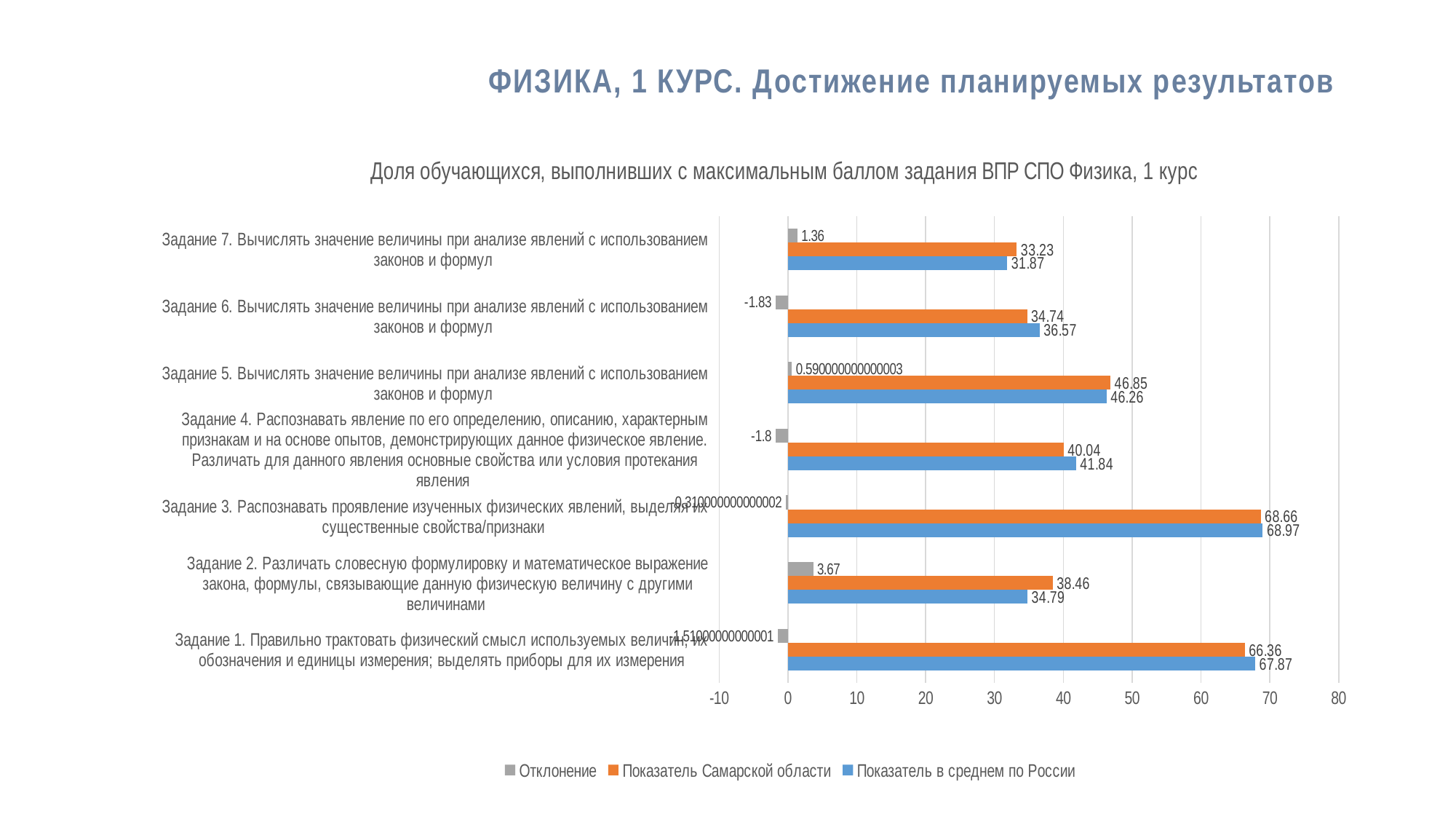
How many tasks (categories) are plotted on the chart? 7 How many series does the legend list? 3 Which task has the highest value for Показатель в среднем по России? Задание 3 Which task has the lowest value for Показатель Самарской области? Задание 7 What is the value of Показатель в среднем по России for Задание 6? 36.57 What type of chart is shown on the slide? bar chart What is the value of Показатель Самарской области for Задание 7? 33.23 What colour are the bars for the series Отклонение? gray Is the value of Показатель Самарской области for Задание 1 greater or less than 60? greater What is the value of Отклонение for Задание 2? 3.67 What is the difference between Показатель в среднем по России and Показатель Самарской области for Задание 4? 1.8 For Задание 2, which is larger: Показатель Самарской области or Показатель в среднем по России? Показатель Самарской области